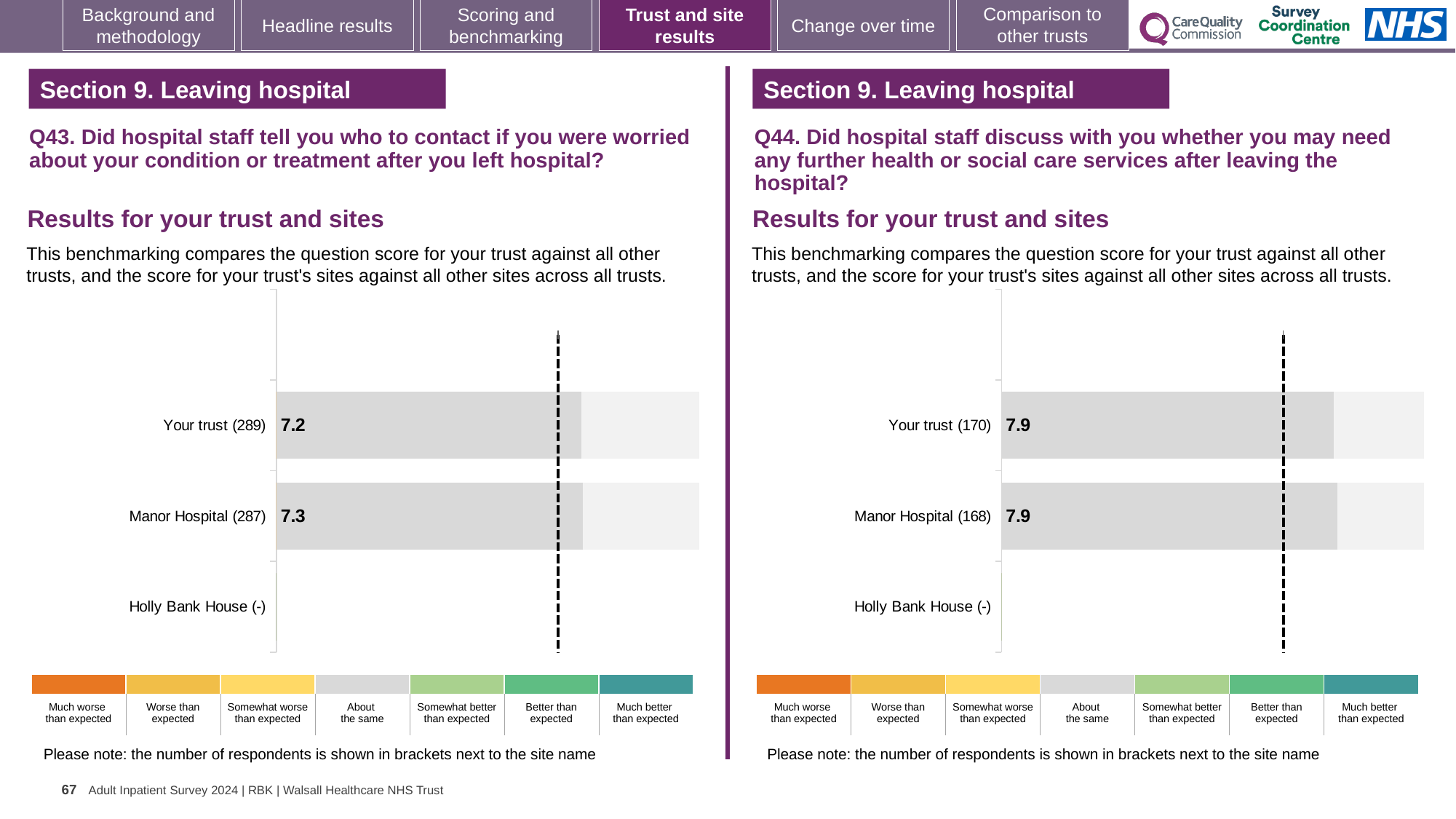
In the Q43 chart on the left, what is the difference between the Manor Hospital score and the Your trust score? 0.1 In the Q43 chart on the left, what is the score for Manor Hospital? 7.3 In the Q43 chart on the left, what is the score for Your trust? 7.2 How many sites or categories are listed on the y axis of the Q43 chart on the left? 3 In the Q43 chart on the left, which has the higher score, Your trust or Manor Hospital? Manor Hospital In the Q44 chart on the right, what is the difference between the Your trust score and the Manor Hospital score? 0 In the Q44 chart on the right, what is the score for Manor Hospital? 7.9 In the Q44 chart on the right, what is the score for Your trust? 7.9 In the Q44 chart on the right, which site has no score shown? Holly Bank House In the Q44 chart on the right, how many respondents are shown in brackets for Manor Hospital? 168 What kind of chart is used for the Q44 results on the right? Bar chart In the Q43 chart on the left, how many respondents are shown in brackets for Your trust? 289